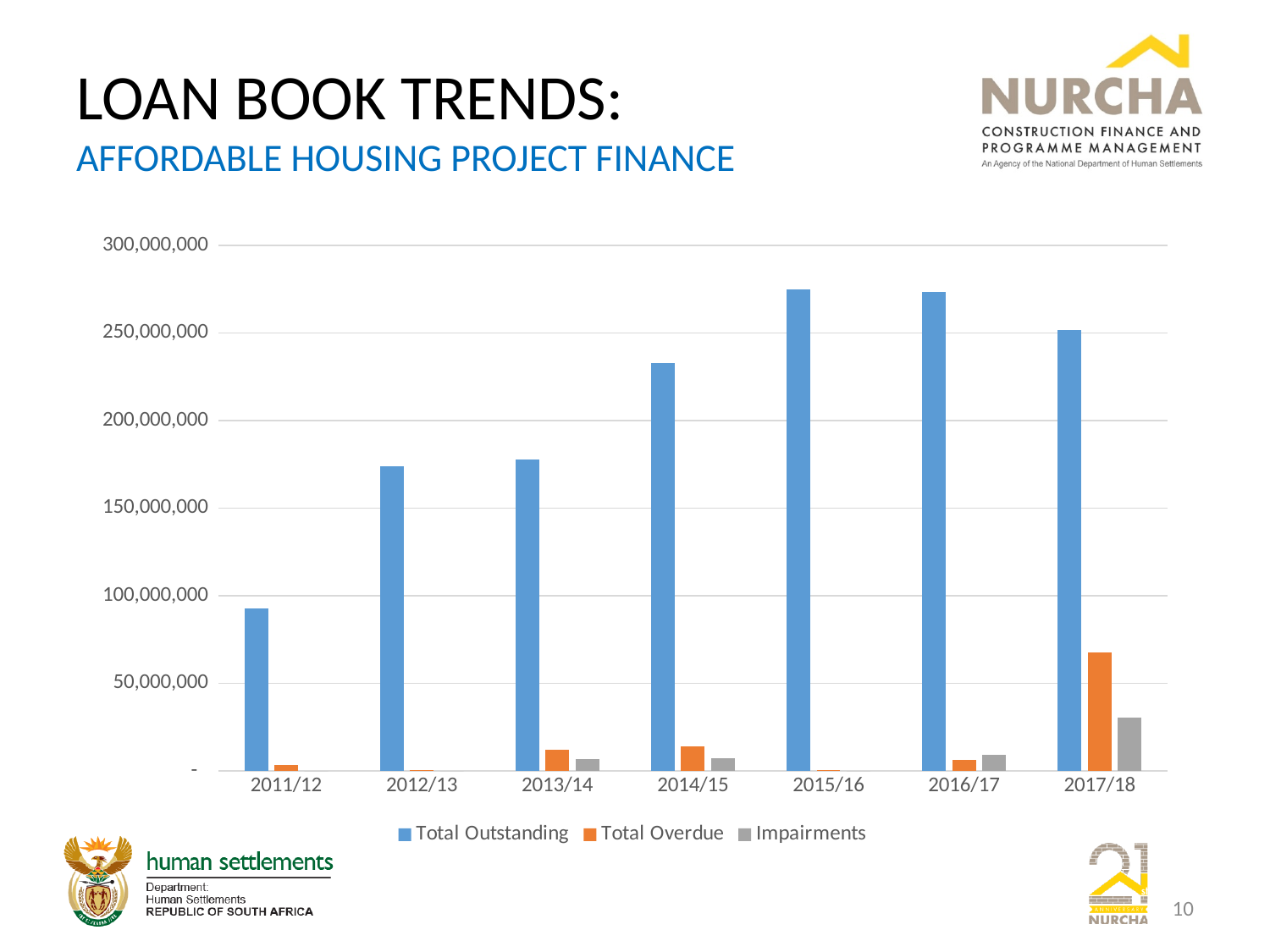
Is the Total Overdue value for 2017/18 greater or less than 50,000,000? greater What kind of chart is shown on the slide? Bar chart Does the Total Outstanding value rise or fall from 2011/12 to 2015/16? Rise Is the Total Outstanding value for 2014/15 greater or less than 200,000,000? greater How many series does the legend list? 3 Which year has the highest Impairments value? 2017/18 Which year has the highest Total Overdue value? 2017/18 How many financial years are shown on the x axis? 7 Which year has the lowest Total Outstanding value? 2011/12 Is the Total Outstanding value for 2011/12 greater or less than 100,000,000? less Which is larger, the Total Outstanding value for 2013/14 or for 2014/15? 2014/15 In 2017/18, which is larger, Total Overdue or Impairments? Total Overdue